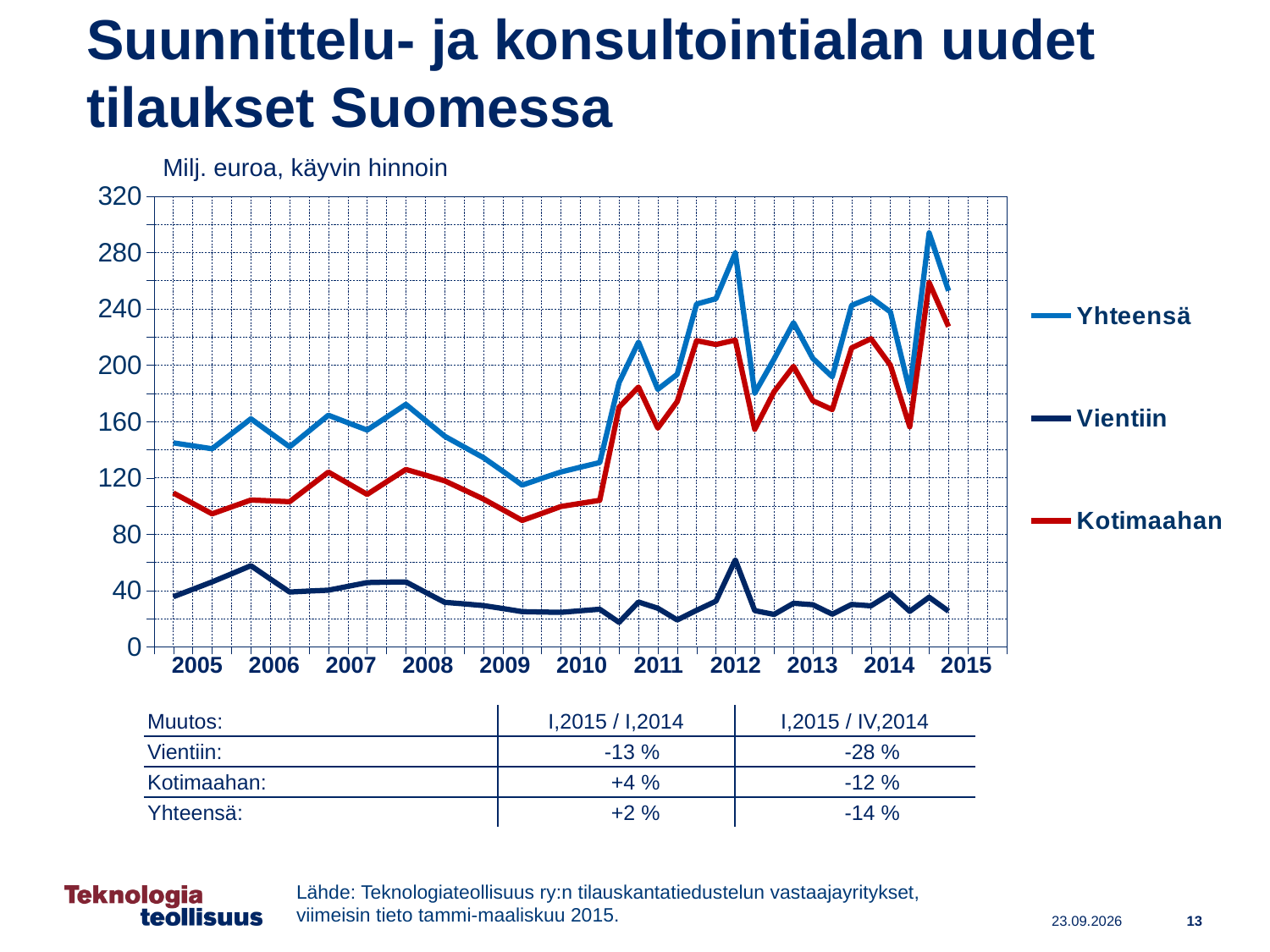
What unit label is shown above the chart's y axis? Milj. euroa, käyvin hinnoin How many series does the chart legend list? 3 How many years are labelled on the x axis of the chart? 11 Which series has the highest values throughout the chart? Yhteensä Which series has the lowest values throughout the chart? Vientiin Is the value of the Vientiin series at the start of 2011 greater or less than 40? less Is the peak value of the Yhteensä series in 2012 greater or less than 240? greater What kind of chart is shown on the slide? line chart Does the Yhteensä series rise or fall between 2008 and 2009? fall Is the value of the Yhteensä series at the start of 2005 greater or less than 120? greater In 2010, which series has the larger value, Kotimaahan or Vientiin? Kotimaahan What are the three series named in the chart legend? Yhteensä, Vientiin, Kotimaahan